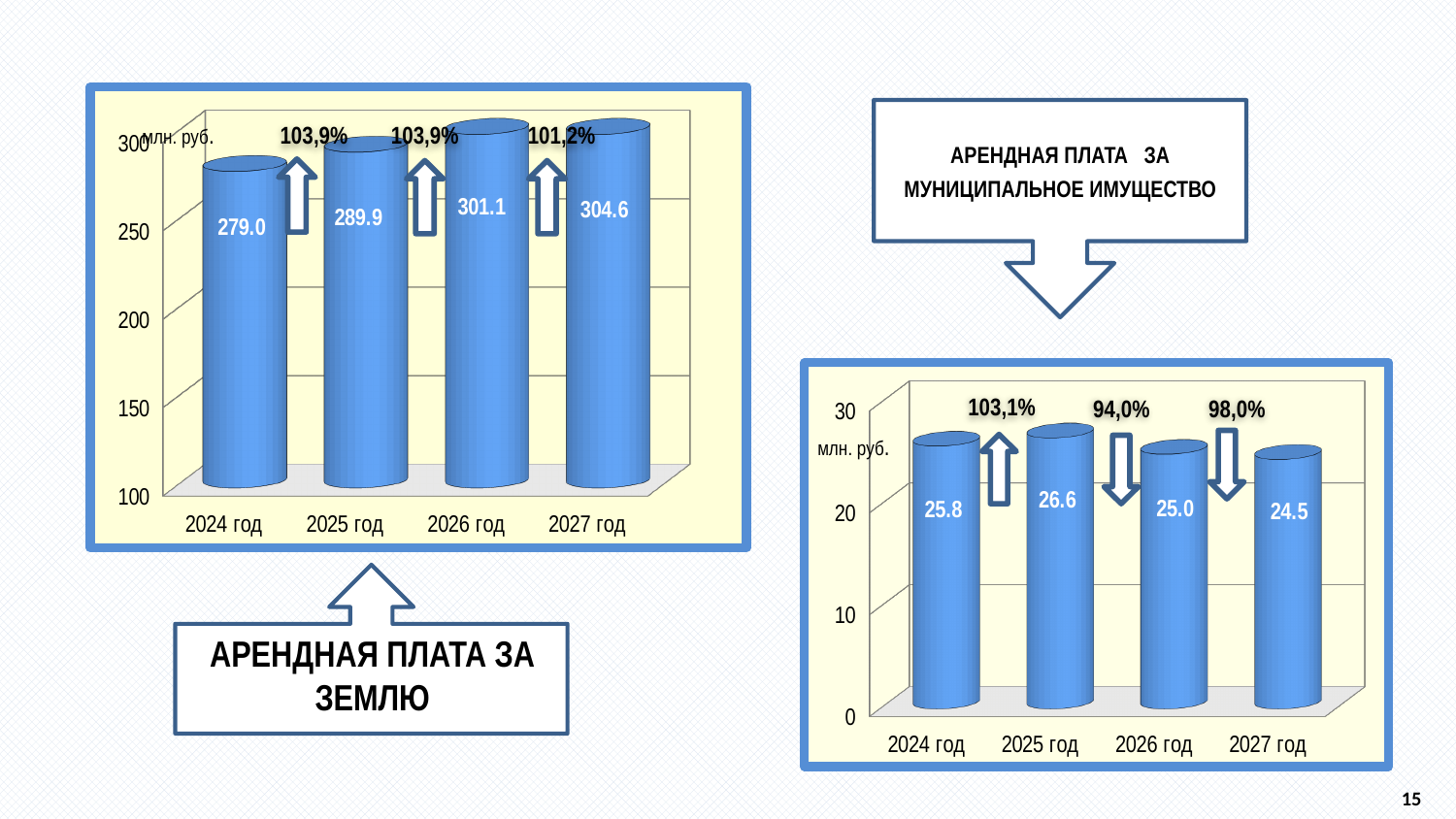
On the 'Арендная плата за муниципальное имущество' chart, how many years are shown on the x axis? 4 On the 'Арендная плата за землю' chart, which year has the lowest value? 2024 год On the 'Арендная плата за землю' chart, do the values rise or fall from 2024 год to 2027 год? rise On the 'Арендная плата за землю' chart, which year has the highest value? 2027 год On the 'Арендная плата за землю' chart, what is the difference between the values for 2027 год and 2024 год? 25.6 On the 'Арендная плата за землю' chart, what percentage is shown above the 2027 год bar? 101,2% On the 'Арендная плата за муниципальное имущество' chart, which year has the lowest value? 2027 год On the 'Арендная плата за землю' chart, what is the value for 2025 год? 289.9 On the 'Арендная плата за муниципальное имущество' chart, what is the difference between the values for 2025 год and 2027 год? 2.1 On the 'Арендная плата за муниципальное имущество' chart, which year has the highest value? 2025 год On the 'Арендная плата за муниципальное имущество' chart, what is the value for 2026 год? 25.0 What type of chart is the 'Арендная плата за землю' chart? bar chart